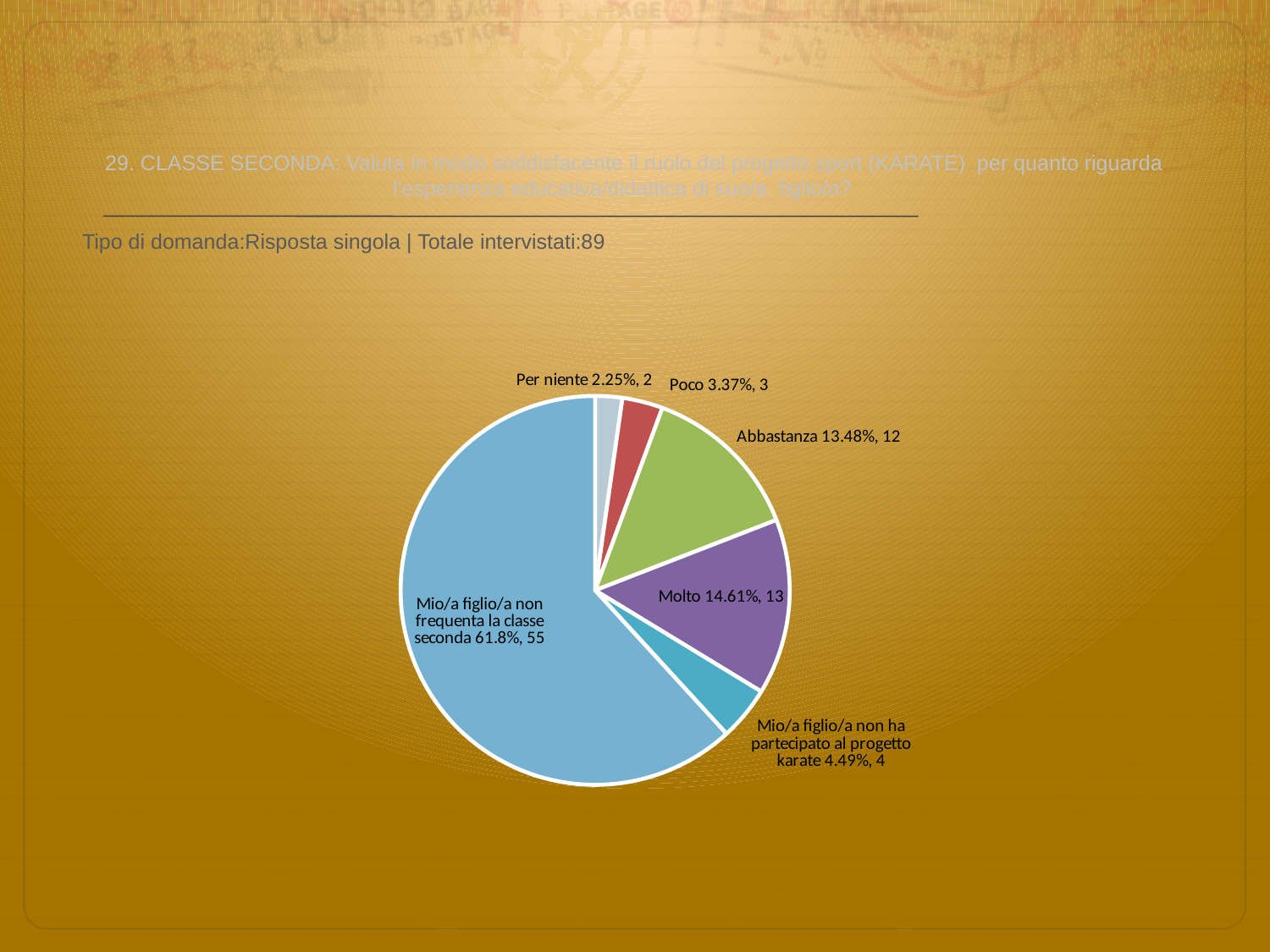
Which has more respondents, 'Mio/a figlio/a non ha partecipato al progetto karate' or 'Poco'? Mio/a figlio/a non ha partecipato al progetto karate What percentage share does the 'Molto' slice have? 14.61% How many slices does the pie chart have? 6 How many respondents answered 'Abbastanza'? 12 What kind of chart is shown on the slide? pie chart What is the total number of respondents stated on the slide? 89 What is the percentage share of the 'Per niente' slice? 2.25% Which category has the smallest slice of the pie? Per niente What is the difference in count between 'Molto' and 'Abbastanza'? 1 How many respondents answered 'Poco'? 3 What is the percentage share of the 'Mio/a figlio/a non frequenta la classe seconda' slice? 61.8% Which category has the largest slice of the pie? Mio/a figlio/a non frequenta la classe seconda